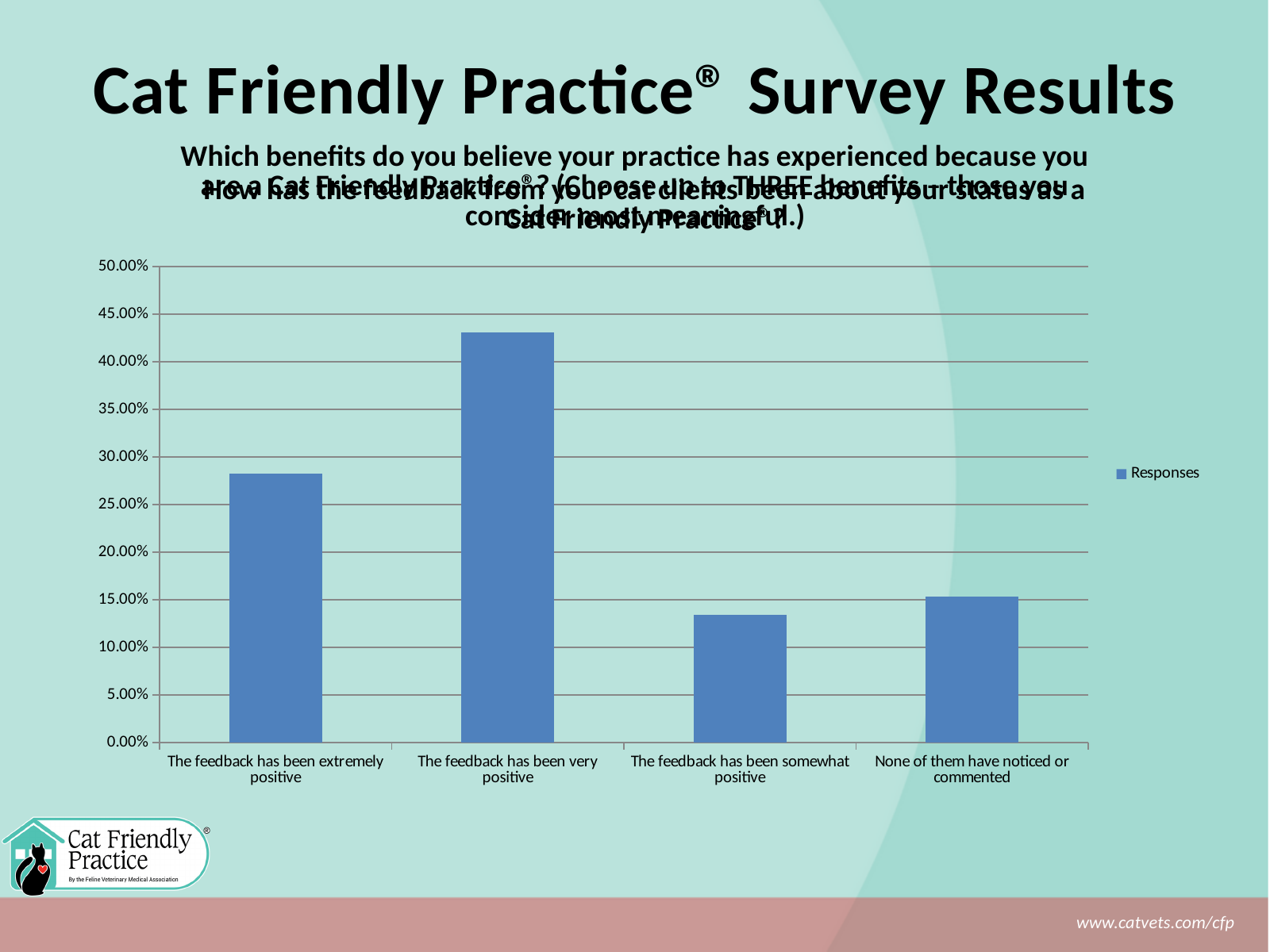
Which category has the highest bar in the chart? The feedback has been very positive How many series does the chart's legend list? 1 Is the value for "None of them have noticed or commented" greater or less than 20.00%? less How many categories are shown on the x axis of the chart? 4 Is the value for "The feedback has been very positive" greater or less than 40.00%? greater What kind of chart is shown on the slide? bar chart Which category has the lowest bar in the chart? The feedback has been somewhat positive What is the highest value shown on the chart's y axis? 50.00% What is the name of the series listed in the chart's legend? Responses Is the value for "The feedback has been somewhat positive" greater or less than 15.00%? less Which is larger: the value for "The feedback has been extremely positive" or the value for "The feedback has been very positive"? The feedback has been very positive